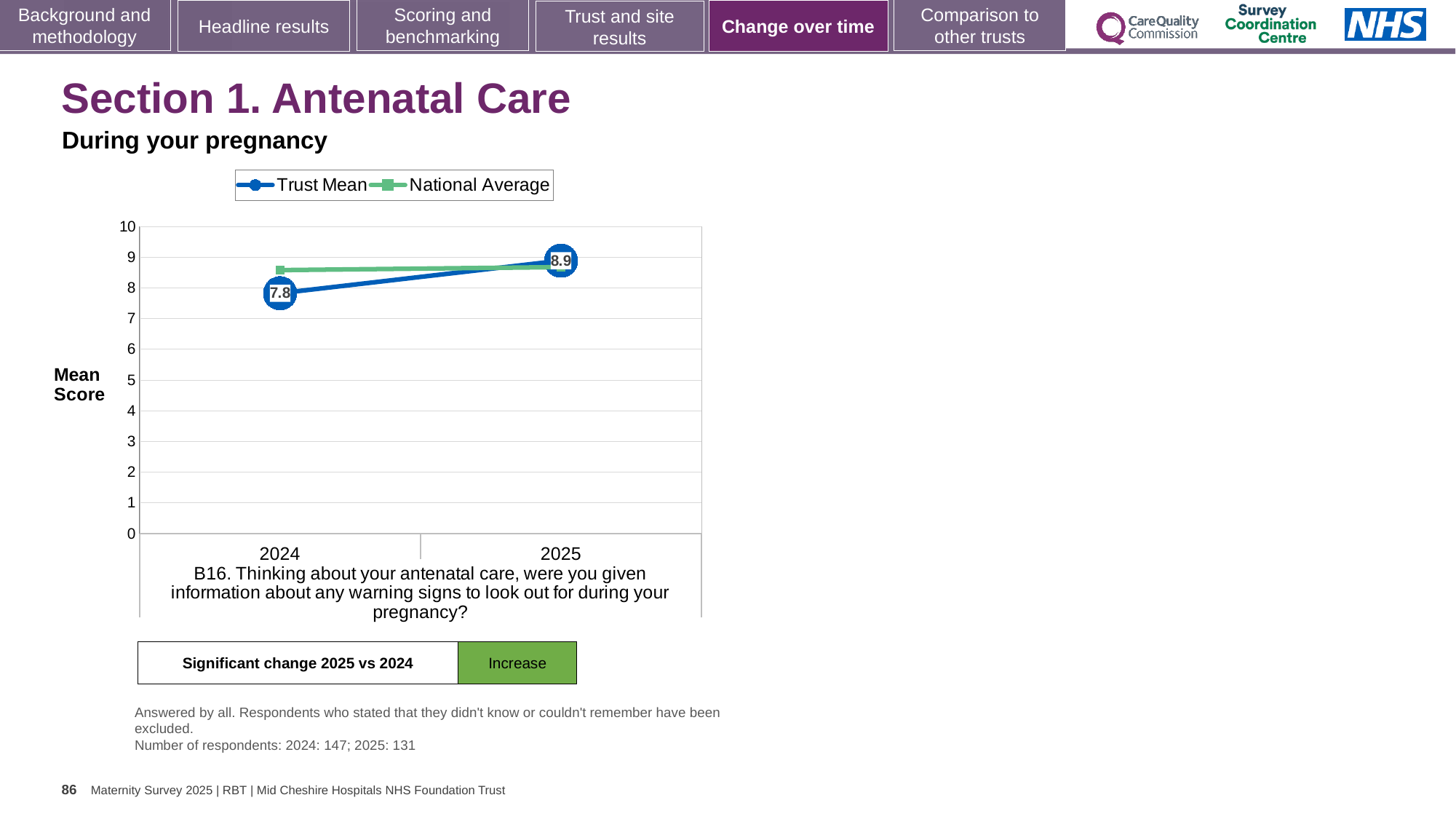
Does the Trust Mean rise or fall from 2024 to 2025? rise What is the Trust Mean value for 2025? 8.9 What are the two series named in the legend? Trust Mean and National Average Which year has the higher Trust Mean, 2024 or 2025? 2025 In 2024, which is higher: the Trust Mean or the National Average? National Average By how much did the Trust Mean change from 2024 to 2025? 1.1 How many series does the legend list? 2 Is the National Average value for 2025 greater or less than 9? less What kind of chart is shown on the slide? line chart What is the Trust Mean value for 2024? 7.8 Is the National Average value for 2024 greater or less than 8? greater How many years are plotted on the x axis? 2